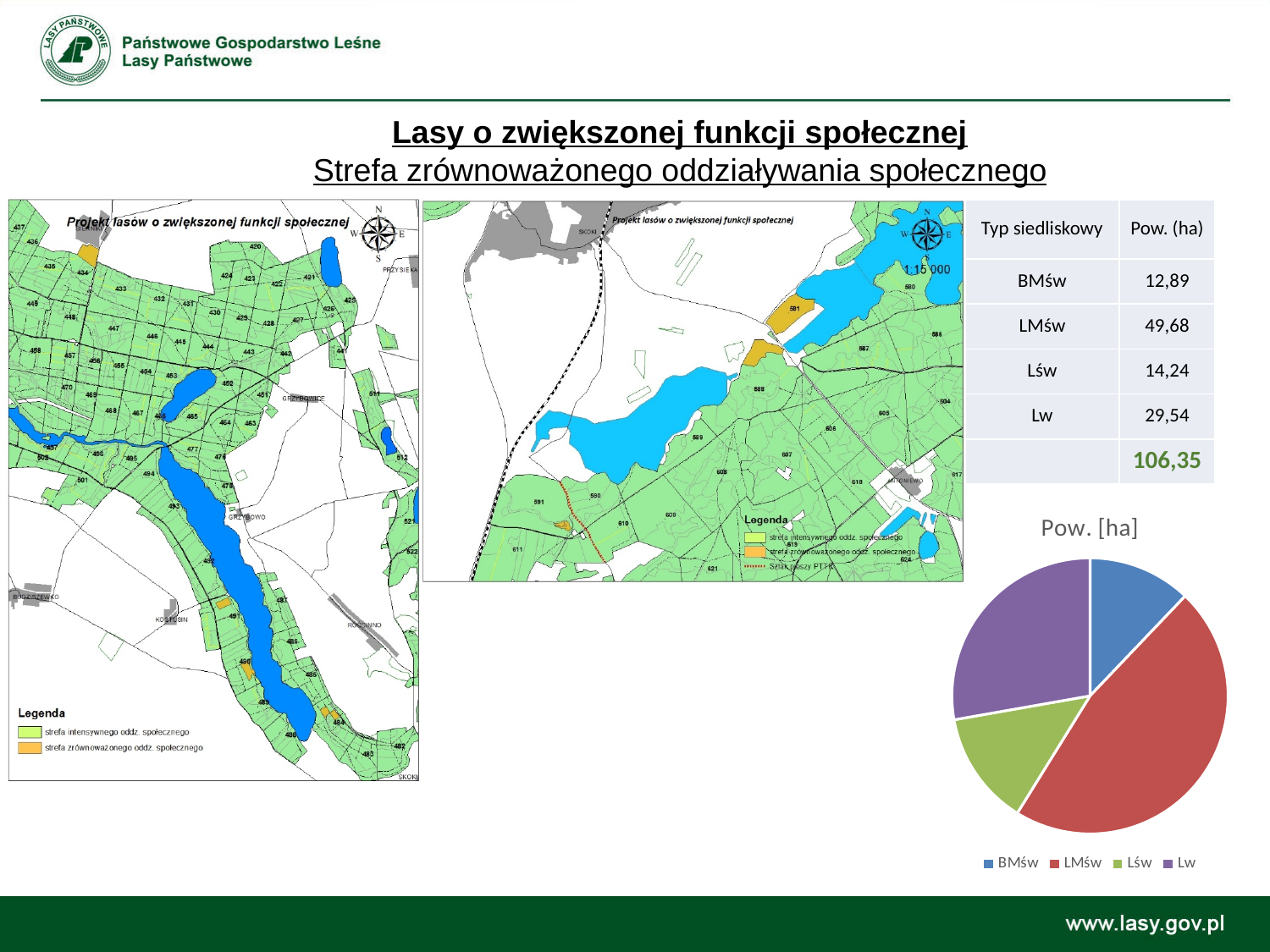
What is the area (Pow. ha) for LMśw shown in the table next to the pie chart? 49,68 What is the area (Pow. ha) for Lw shown in the table next to the pie chart? 29,54 What is the difference between the LMśw and Lw values in the table next to the pie chart? 20,14 Which category has the largest slice in the pie chart? LMśw How many entries does the legend of the pie chart list? 4 What kind of chart is shown at the bottom right of the slide? pie chart Which category has the smallest slice in the pie chart, according to the values in the table? BMśw What colour is the LMśw slice in the pie chart? red Which slice is larger in the pie chart, Lw or Lśw? Lw How many slices does the pie chart have? 4 What is the title of the pie chart? Pow. [ha] What is the total area (ha) of all categories shown in the table next to the pie chart? 106,35